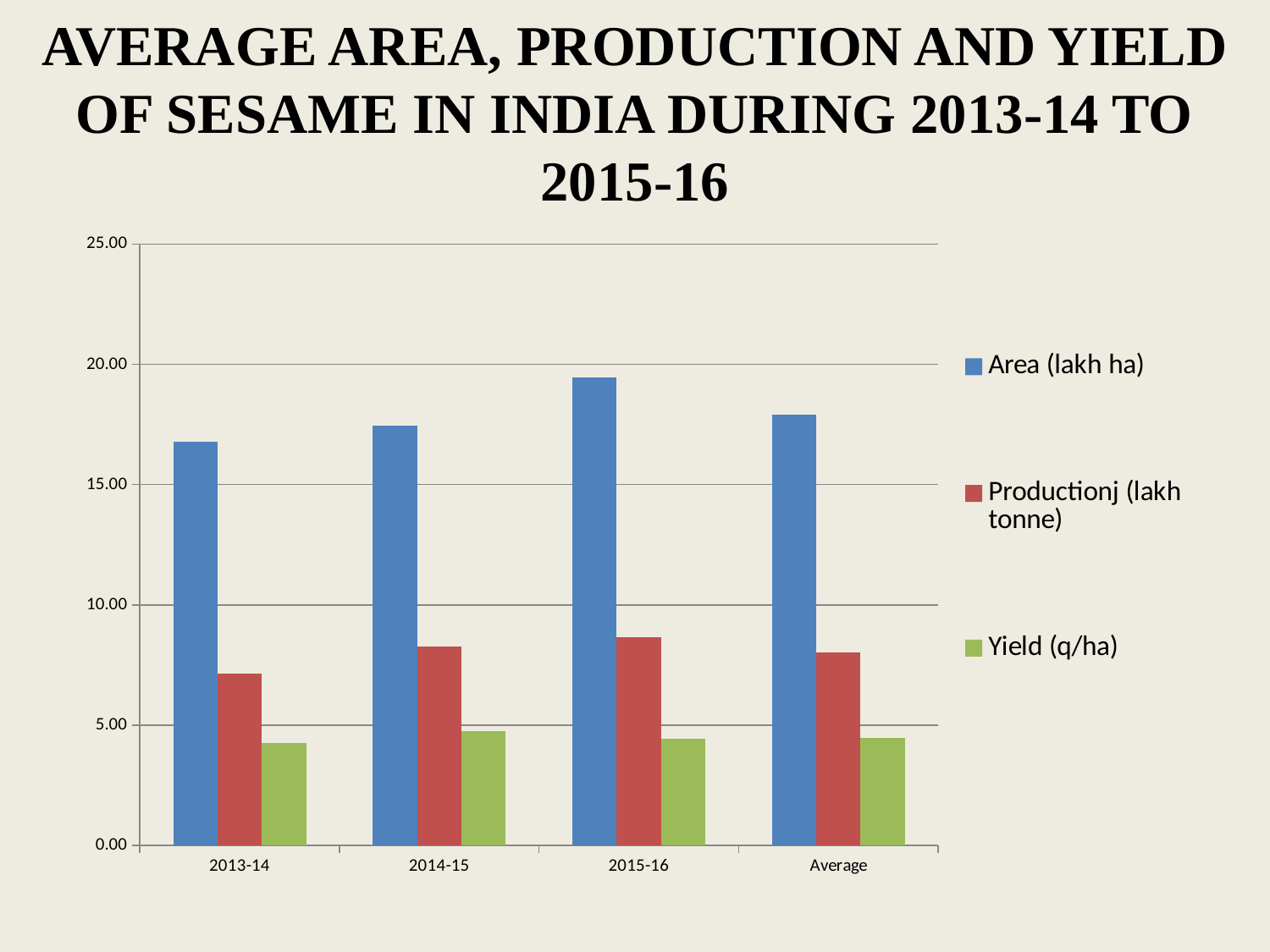
In which category is Area (lakh ha) the lowest? 2013-14 Is the value for Yield (q/ha) in 2014-15 greater or less than 5.00? less In which category is Area (lakh ha) the highest? 2015-16 How many series does the legend list? 3 Does Area (lakh ha) rise or fall from 2013-14 to 2015-16? rise How many categories are shown on the x axis? 4 Which is larger: Area (lakh ha) in 2015-16 or Area (lakh ha) in 2014-15? 2015-16 Is the value for Productionj (lakh tonne) in 2014-15 greater or less than 5.00? greater In which category is Productionj (lakh tonne) the lowest? 2013-14 Is the value for Area (lakh ha) in 2013-14 greater or less than 20.00? less What kind of chart is shown on the slide? bar chart